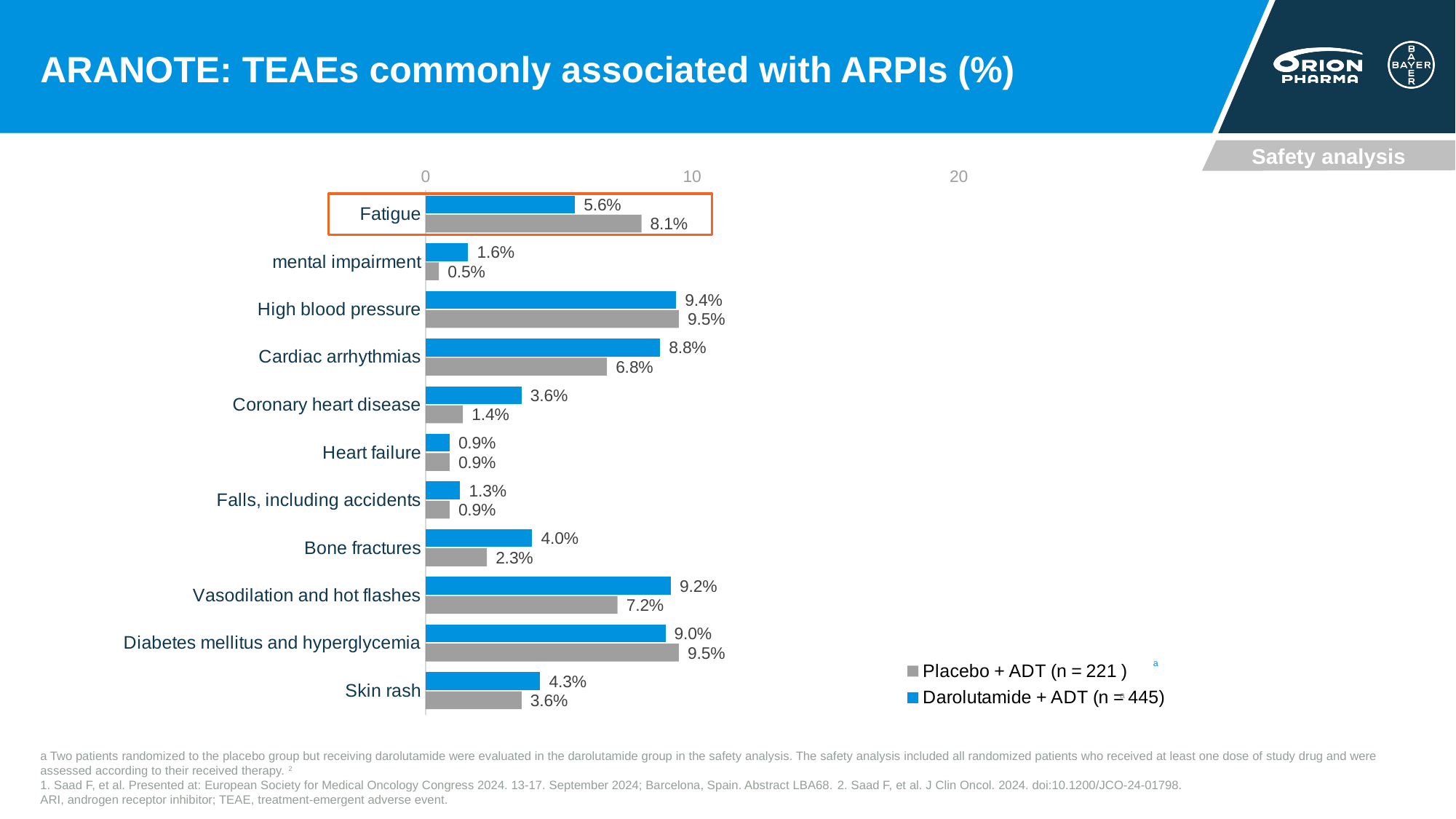
What is the difference between the Placebo + ADT and Darolutamide + ADT values for Fatigue? 2.5% What is the value for Placebo + ADT for Cardiac arrhythmias? 6.8% Which category has the lowest value for Placebo + ADT? mental impairment How many series does the legend list? 2 Which category is highlighted with an orange box on the chart? Fatigue How many categories are shown on the chart? 11 What is the difference between the Darolutamide + ADT and Placebo + ADT values for Vasodilation and hot flashes? 2.0% What kind of chart is shown on the slide? Bar chart Which category has the highest value for Darolutamide + ADT? High blood pressure What is the value for Darolutamide + ADT for Fatigue? 5.6% Which is larger for Bone fractures: the Darolutamide + ADT value or the Placebo + ADT value? Darolutamide + ADT What is the value for Placebo + ADT for Diabetes mellitus and hyperglycemia? 9.5%